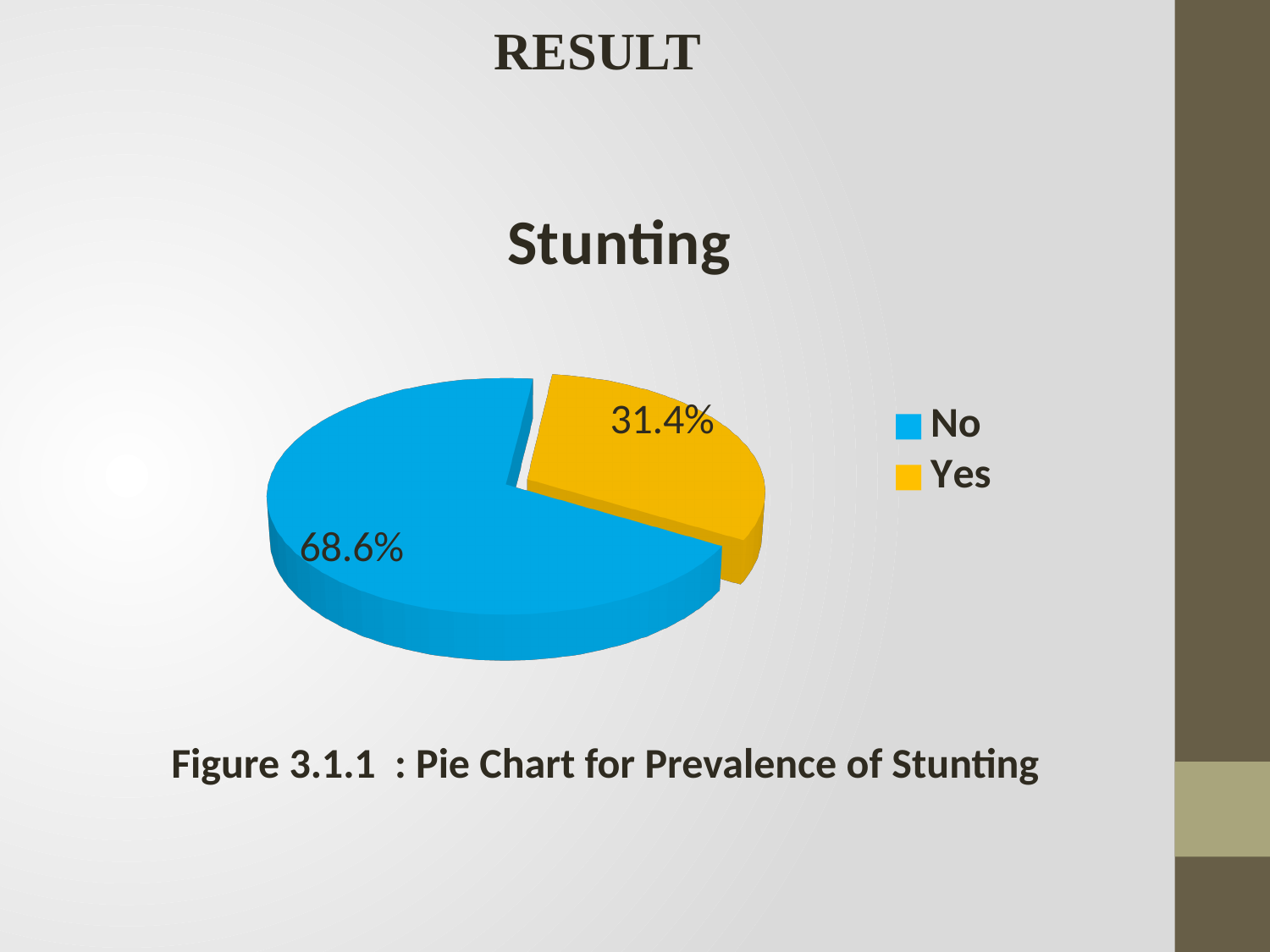
Which category has the smallest slice in the pie chart? Yes Which slice is larger, "No" or "Yes"? No What percentage of the pie chart is labelled "No"? 68.6% How many entries does the legend list? 2 What is the difference in percentage points between the "No" slice and the "Yes" slice? 37.2 What percentage of the pie chart is labelled "Yes"? 31.4% How many slices does the pie chart have? 2 Which category has the largest slice in the pie chart? No What share of the pie does the "Yes" slice represent? 31.4% What kind of chart is shown on the slide? Pie chart What colour is the "Yes" slice in the pie chart? Yellow What is the title of the chart? Stunting